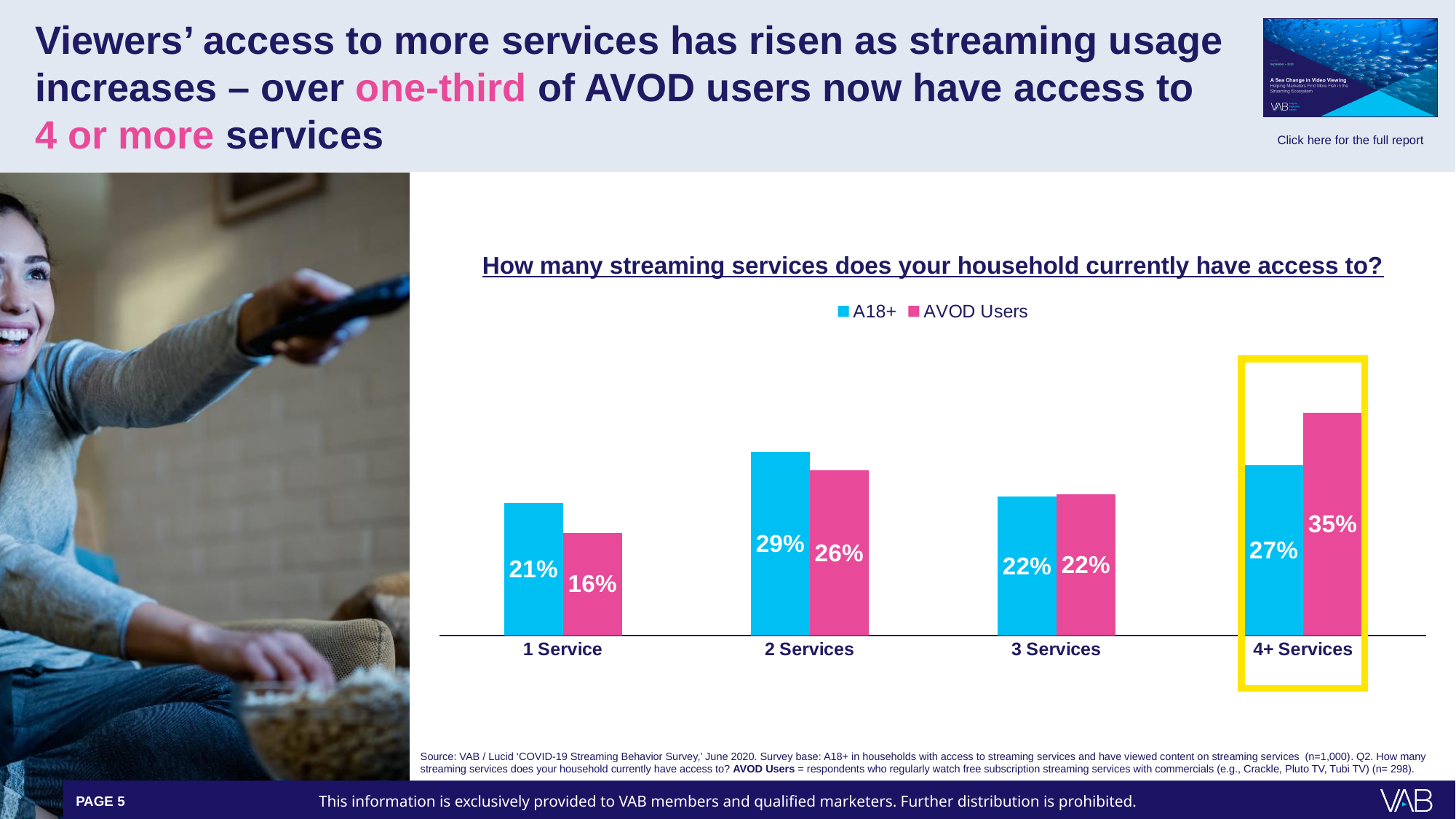
What is the title of the chart? How many streaming services does your household currently have access to? How many categories are shown on the x axis? 4 What is the AVOD Users value for 1 Service? 16% For 1 Service, which series has the larger value, A18+ or AVOD Users? A18+ What is the A18+ value for 2 Services? 29% Which category is highlighted with a yellow box? 4+ Services What percentage of AVOD Users have access to 4+ Services? 35% What kind of chart is shown on the slide? Bar chart What is the difference between the AVOD Users and A18+ values for 4+ Services? 8% How many series does the legend list? 2 Which category has the highest A18+ value? 2 Services Which category has the lowest AVOD Users value? 1 Service